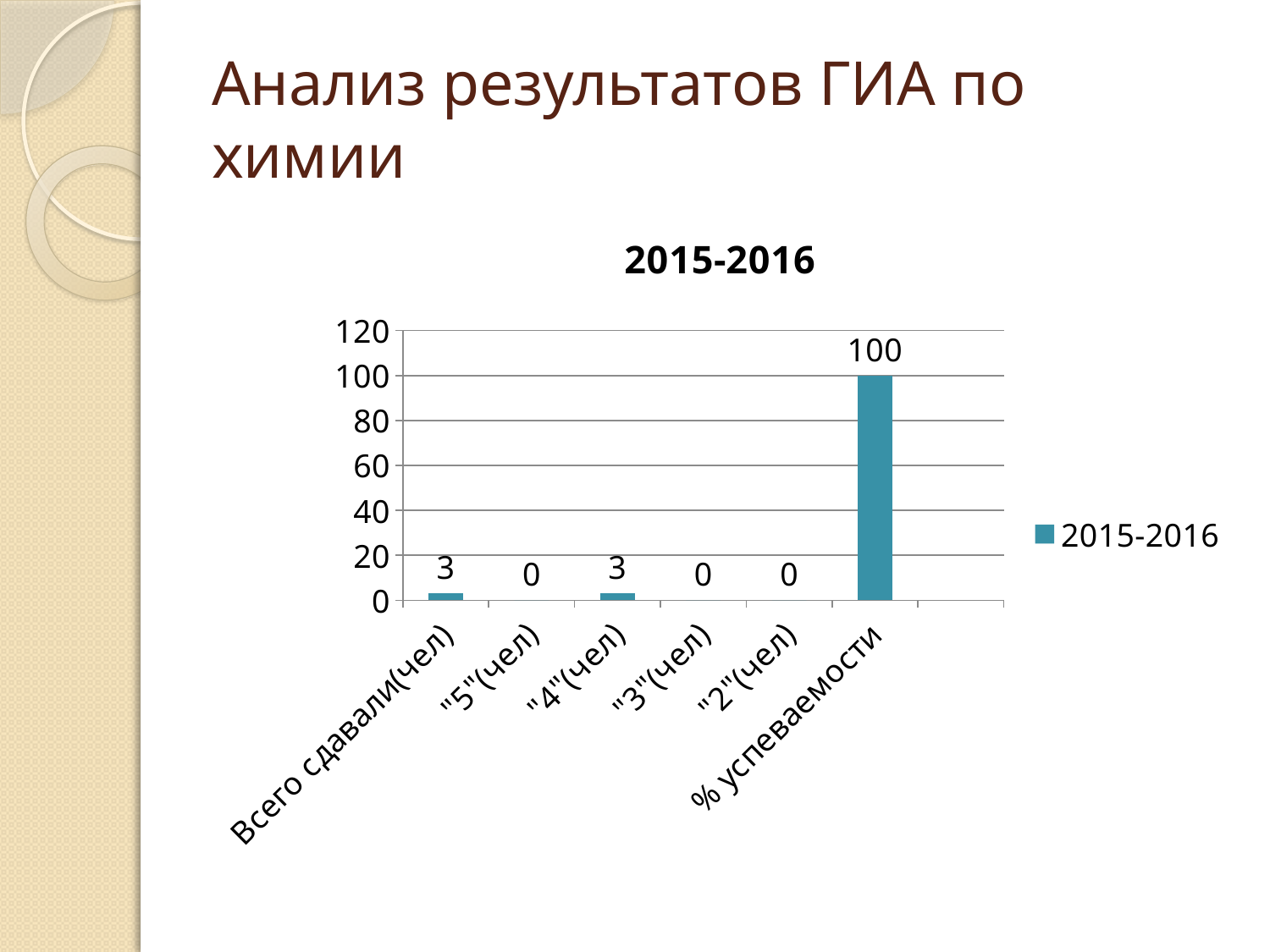
What is the value for "4"(чел)? 3 How many categories are shown on the x axis? 6 What is the value for "5"(чел)? 0 Which is larger, the value for "4"(чел) or the value for "3"(чел)? "4"(чел) What is the difference between the values for "% успеваемости" and "Всего сдавали(чел)"? 97 How many series does the legend list? 1 What is the value for "% успеваемости"? 100 What is the value for "Всего сдавали(чел)"? 3 What kind of chart is shown on the slide? bar chart Which category has the highest value? % успеваемости What is the title of the chart? 2015-2016 Is the value for "% успеваемости" greater or less than 80? greater